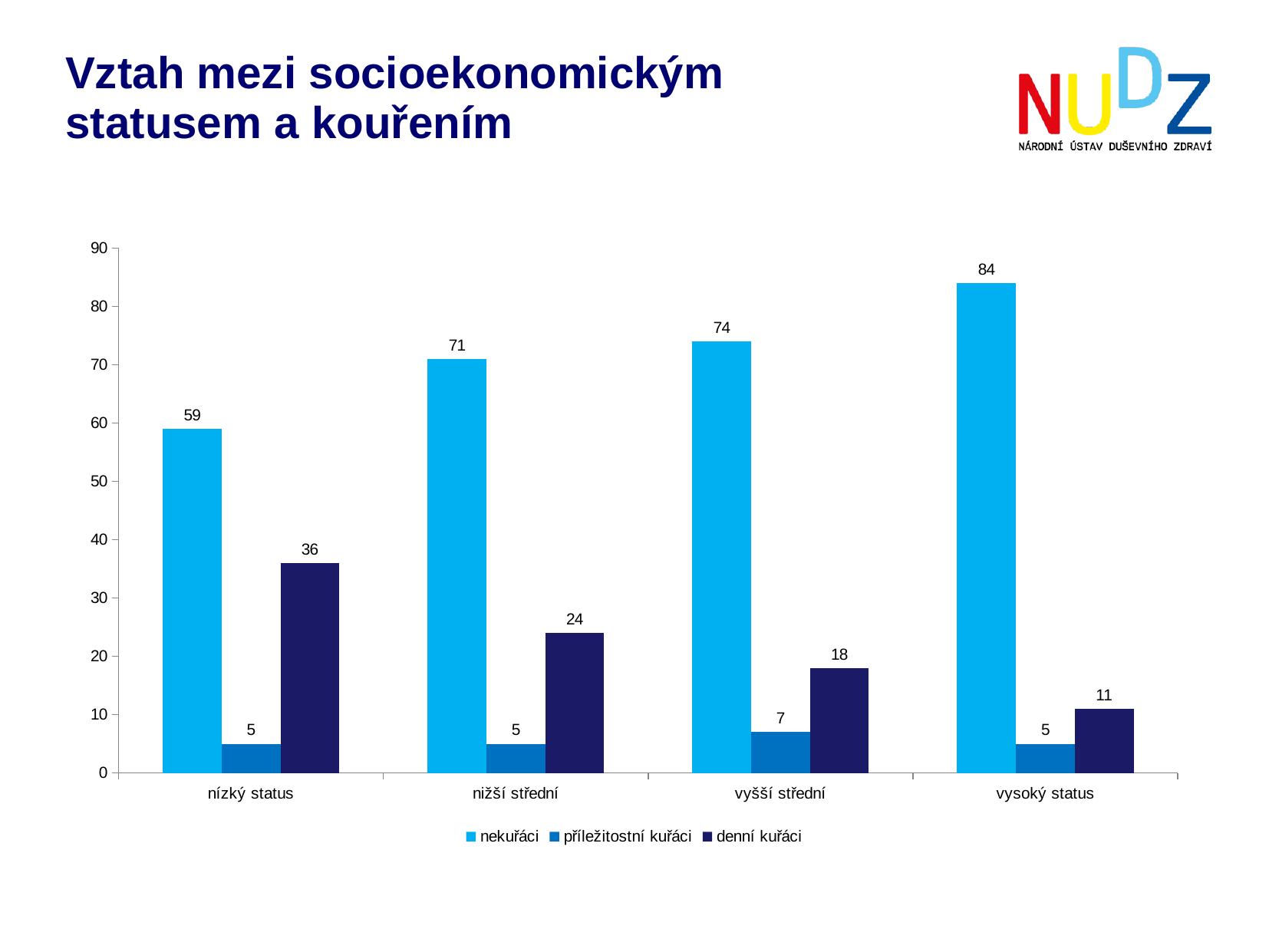
What is the value for příležitostní kuřáci in the vysoký status category? 5 What kind of chart is shown on the slide? bar chart What is the value for denní kuřáci in the vyšší střední category? 18 Which category has the lowest value for denní kuřáci? vysoký status What is the title of the slide? Vztah mezi socioekonomickým statusem a kouřením What is the difference between the nekuřáci values for vysoký status and nízký status? 25 Do the values for nekuřáci rise or fall from nízký status to vysoký status? rise Which category has the highest value for nekuřáci? vysoký status How many categories are shown on the x axis? 4 What is the value for nekuřáci in the nízký status category? 59 Which is larger: denní kuřáci for nízký status or denní kuřáci for nižší střední? nízký status How many series does the legend list? 3